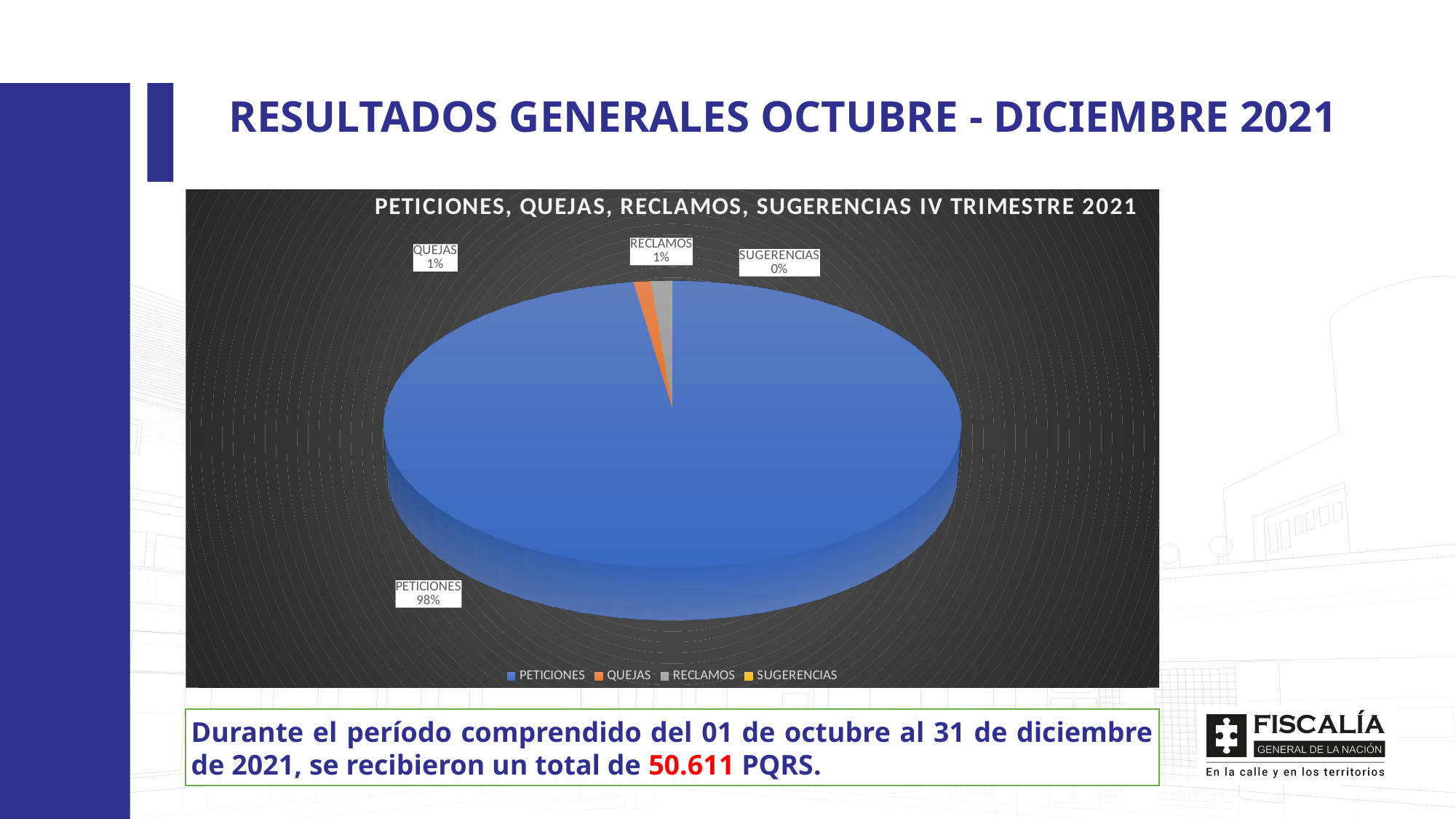
What is the title of the chart? PETICIONES, QUEJAS, RECLAMOS, SUGERENCIAS IV TRIMESTRE 2021 How many categories does the legend list? 4 What share of the pie does QUEJAS represent? 1% What is the difference in percentage points between PETICIONES and QUEJAS? 97 Which category has the largest slice of the pie? PETICIONES Which is larger, the share for PETICIONES or the share for RECLAMOS? PETICIONES What share of the pie does RECLAMOS represent? 1% What share of the pie does PETICIONES represent? 98% What kind of chart is shown on the slide? Pie chart Which category has the smallest slice of the pie? SUGERENCIAS What colour is the PETICIONES slice in the legend? Blue